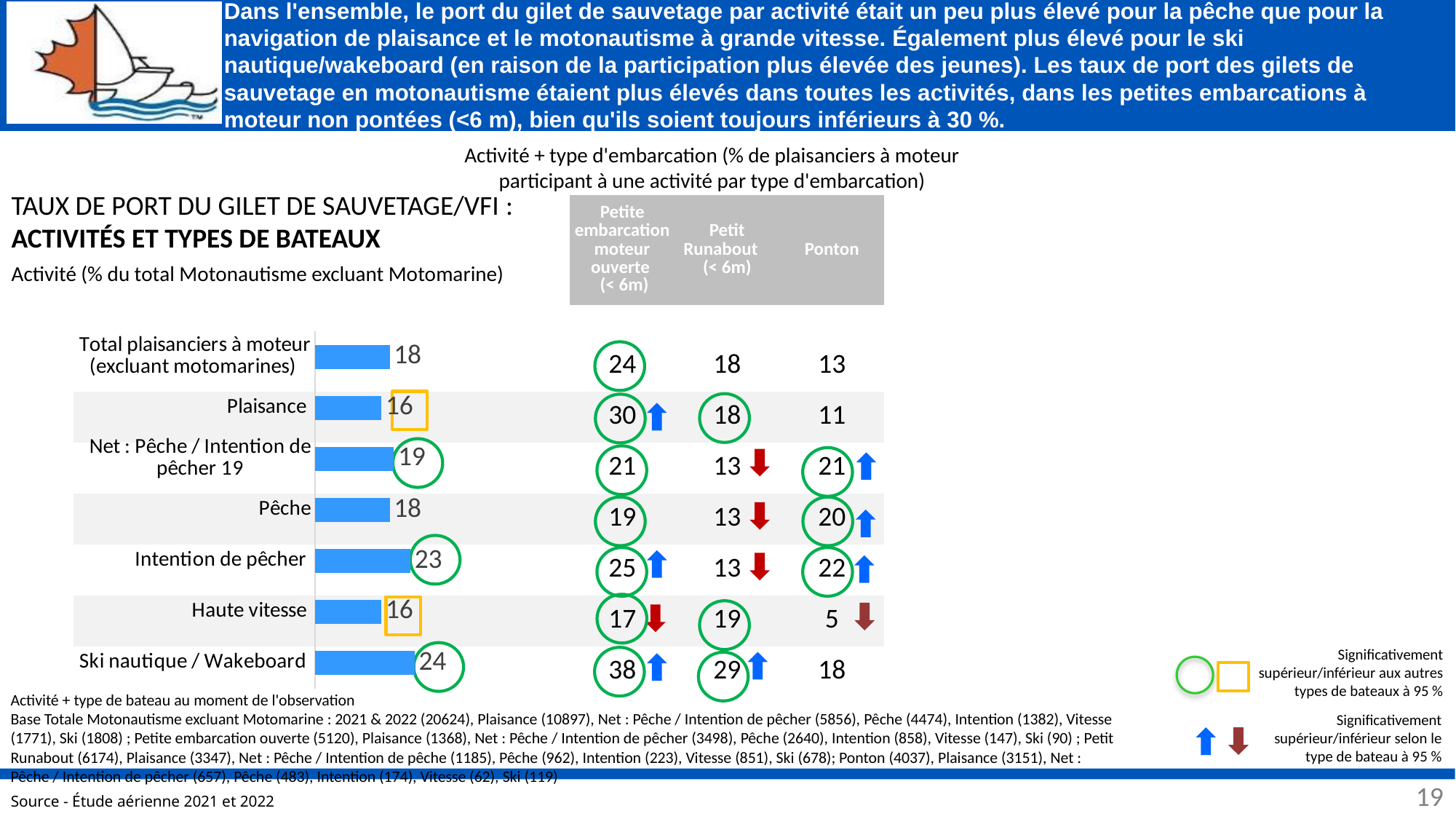
Which category has the highest value in the bar chart? Ski nautique / Wakeboard What colour are the bars in the chart? Blue How many categories are shown in the bar chart? 7 Which is larger in the bar chart, the value for Intention de pêcher or the value for Pêche? Intention de pêcher What is the value for Ski nautique / Wakeboard in the bar chart? 24 What is the difference between the values for Ski nautique / Wakeboard and Plaisance in the bar chart? 8 What is the value for Intention de pêcher in the bar chart? 23 What kind of chart is shown on the slide? Bar chart What is the value for Haute vitesse in the bar chart? 16 What is the value for Total plaisanciers à moteur (excluant motomarines) in the bar chart? 18 What is the difference between the values for Intention de pêcher and Pêche in the bar chart? 5 What is the value for Net : Pêche / Intention de pêcher in the bar chart? 19